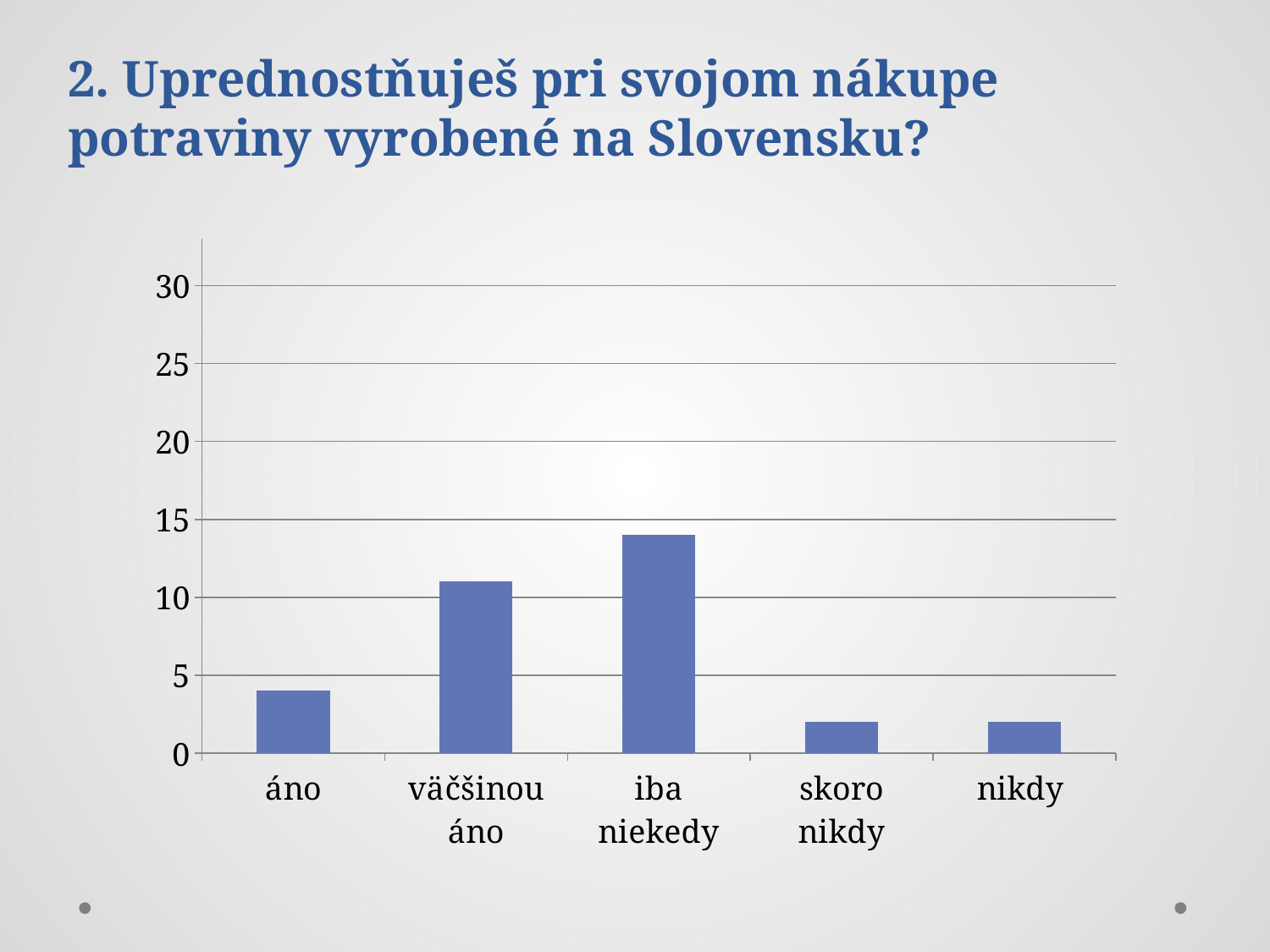
Is the value for "nikdy" greater or less than 5? less Is the value for "skoro nikdy" greater or less than 5? less Is the value for "áno" greater or less than 5? less Which is larger, the value for "áno" or the value for "väčšinou áno"? väčšinou áno What kind of chart is shown on the slide? bar chart How many categories are shown on the x axis of the chart? 5 Which category has the highest bar in the chart? iba niekedy What is the highest value shown on the y axis of the chart? 30 Which is larger, the value for "iba niekedy" or the value for "väčšinou áno"? iba niekedy